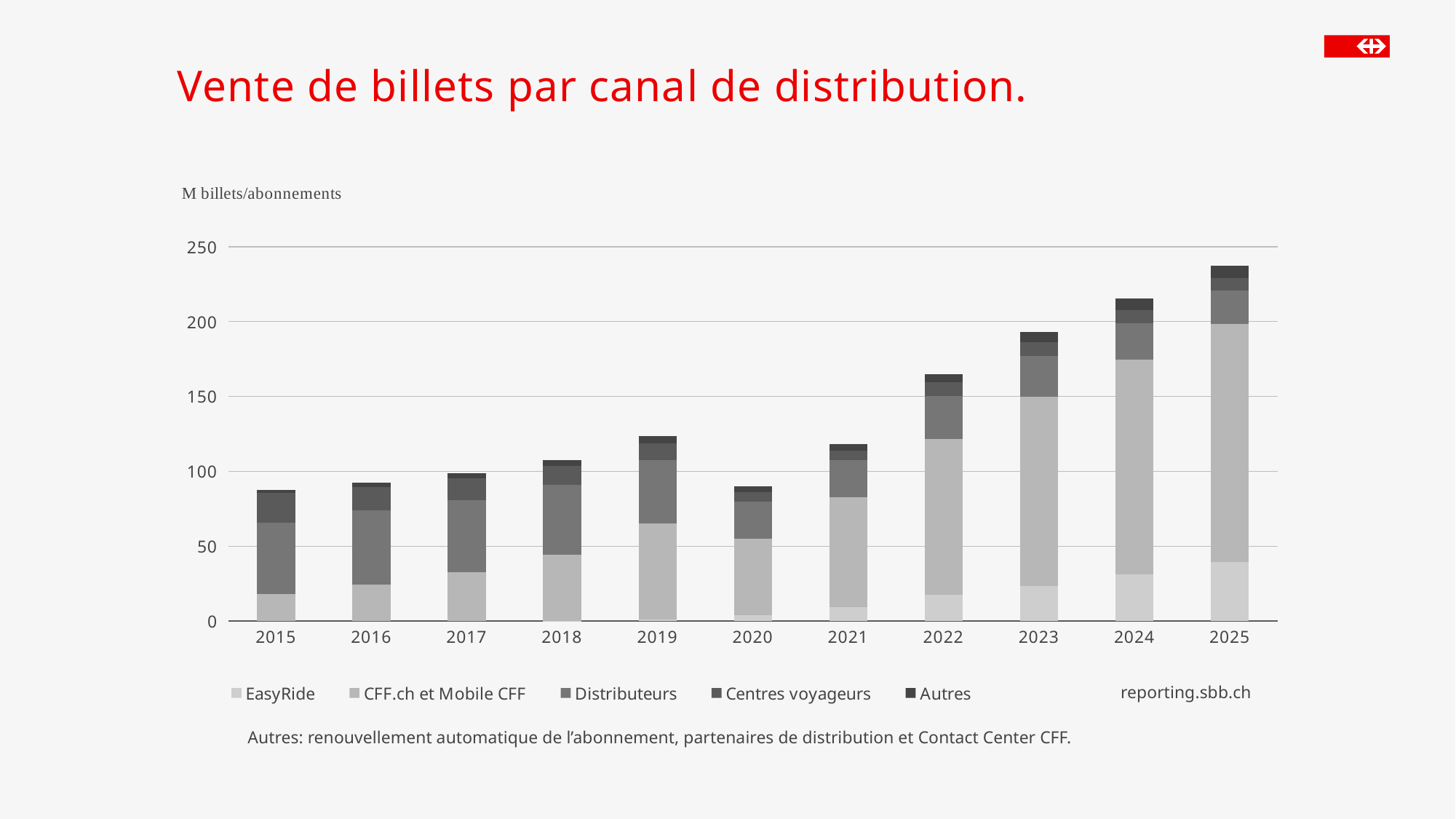
How many years are shown on the x axis of the chart? 11 Is the total bar for 2023 greater or less than 200? less Which year has the highest total bar in the chart? 2025 Is the total bar for 2025 greater or less than 200? greater What is the title of the chart on the slide? Vente de billets par canal de distribution. Which year has the larger total bar, 2019 or 2020? 2019 Is the total bar for 2022 greater or less than 150? greater What kind of chart is shown on the slide? Stacked bar chart What unit label is shown above the y axis of the chart? M billets/abonnements How many series does the chart's legend list? 5 Do the total bars rise or fall from 2020 to 2025? Rise